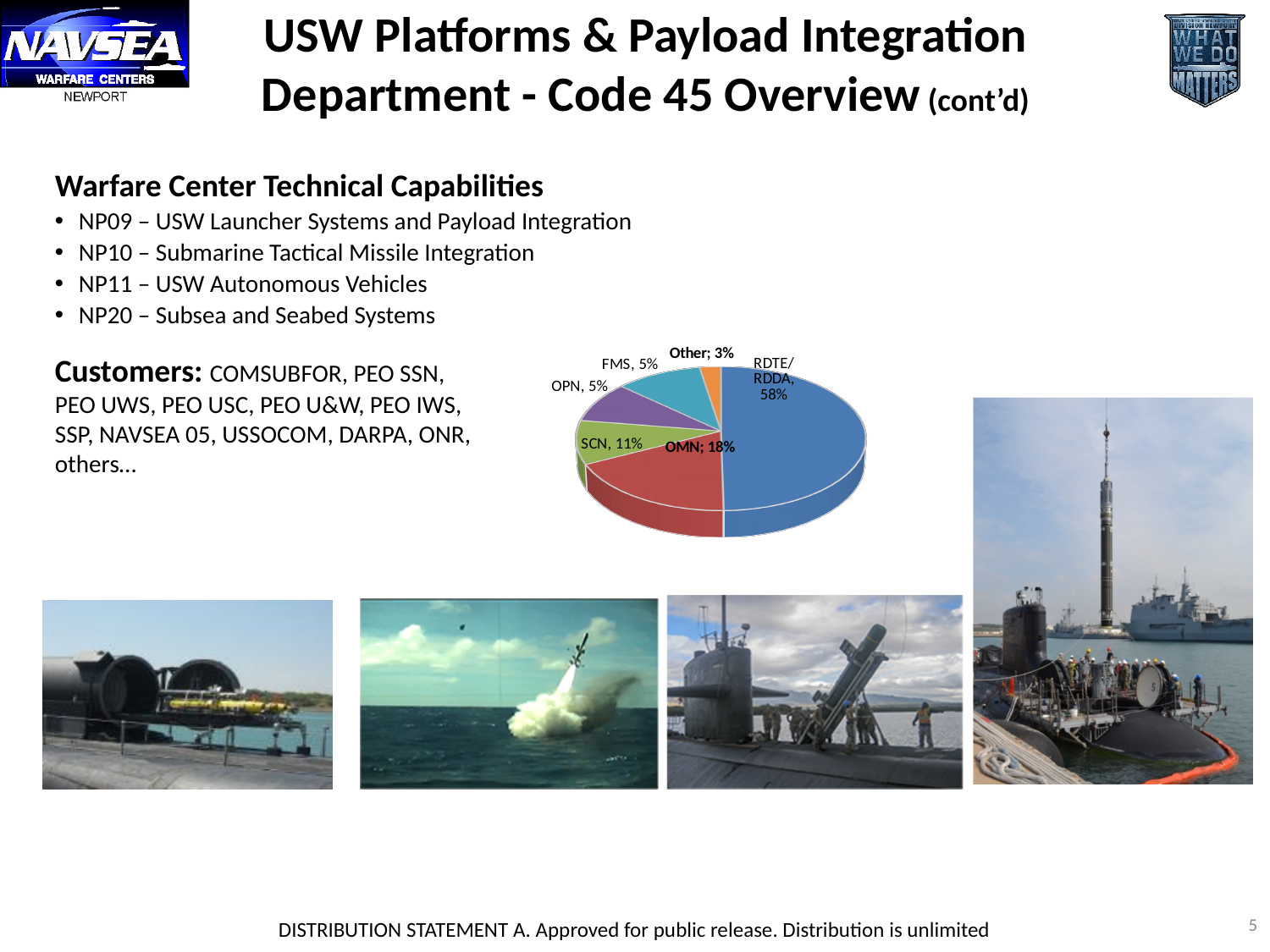
What is the combined share of OPN and FMS? 10% Which slice of the pie chart is the smallest? Other What kind of chart is shown on the slide? pie chart What percentage is shown for SCN? 11% What share of the pie does RDTE/RDDA represent? 58% What percentage is shown for Other? 3% Which slice of the pie chart is the largest? RDTE/RDDA Which slice of the pie chart is coloured blue? RDTE/RDDA Which is larger, the SCN slice or the OPN slice? SCN What is the value shown for OMN in the pie chart? 18% What is the difference in percentage points between RDTE/RDDA and OMN? 40 How many slices does the pie chart have? 6